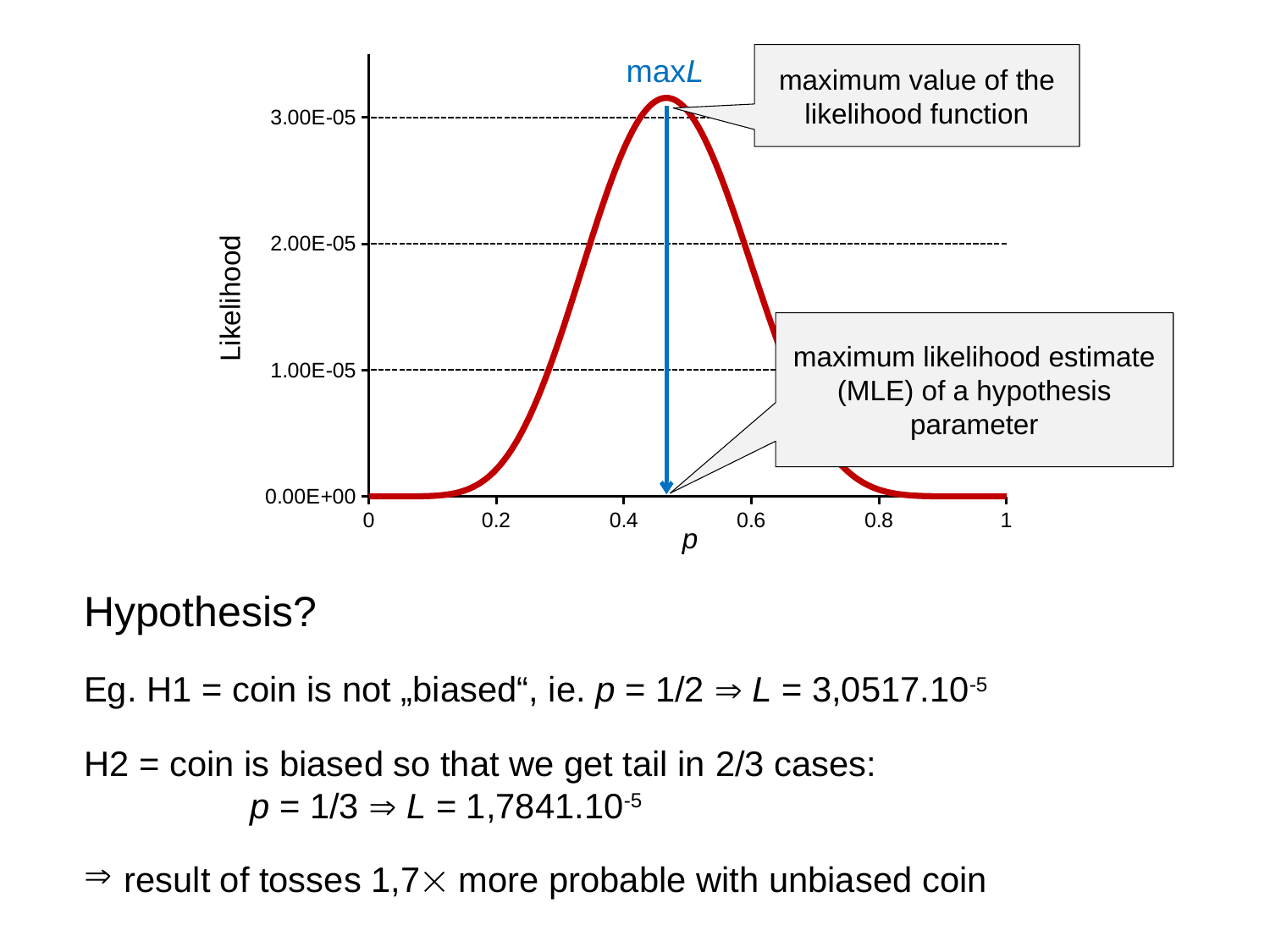
Is the likelihood at p = 0.4 greater or less than 2.00E-05? greater What is the label of the y axis of the chart? Likelihood Does the likelihood curve rise or fall as p increases from 0.6 to 0.8? fall Does the likelihood curve rise or fall as p increases from 0.2 to 0.4? rise How many tick labels are shown on the x axis of the chart? 6 Is the likelihood at p = 0.8 greater or less than 1.00E-05? less Is the likelihood at p = 0.2 greater or less than 1.00E-05? less Between which two x-axis tick values does the peak of the likelihood curve lie? 0.4 and 0.6 How many curves are plotted on the chart? 1 What is the label of the x axis of the chart? p What kind of chart is shown on the slide? line chart